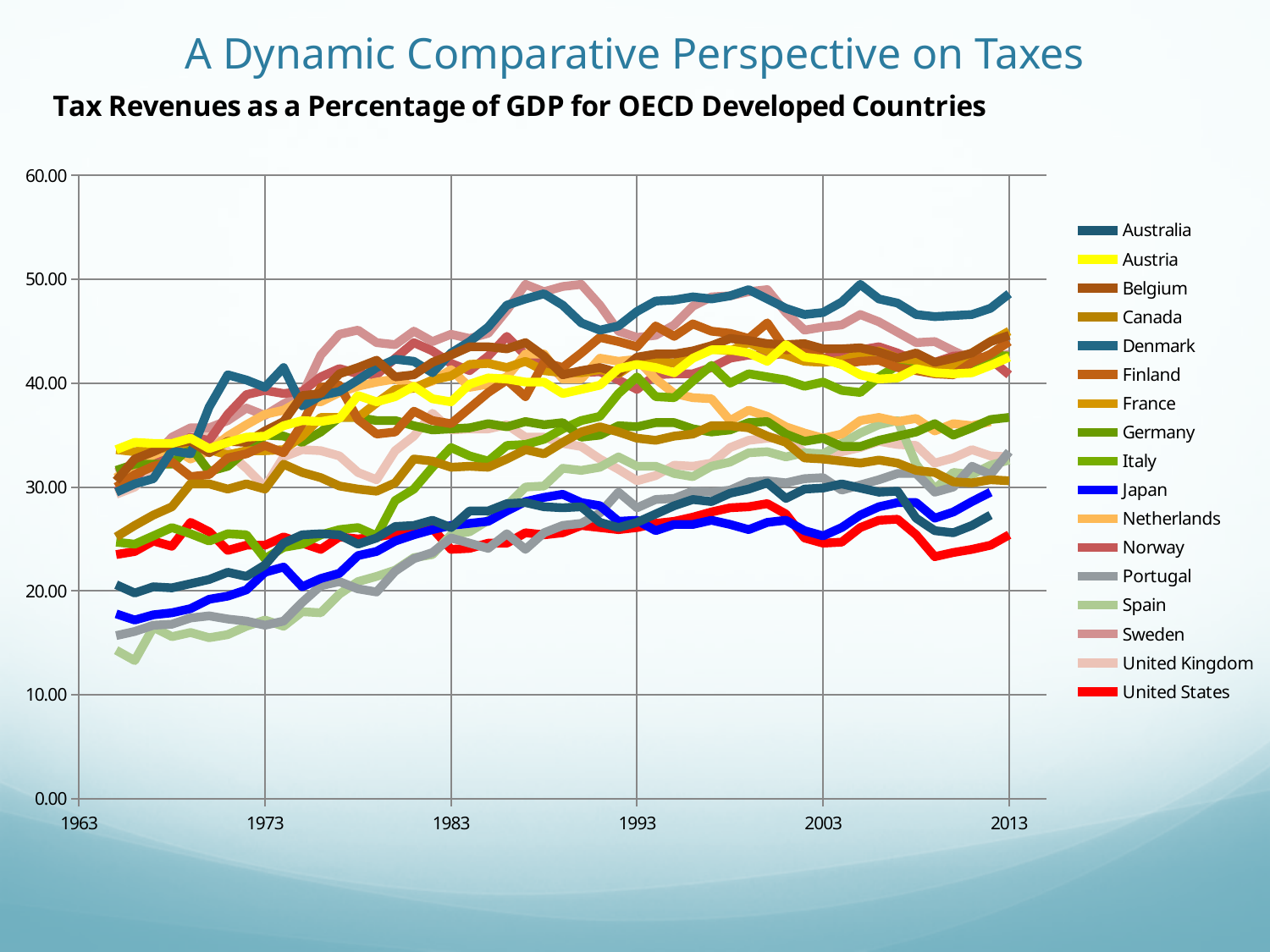
Which country has the lowest tax revenue as a percentage of GDP in 2013? United States How many countries are listed in the chart's legend? 17 What kind of chart is shown on the slide? line chart Is the value for Japan in 1993 greater or less than 40? less What is the title of the chart? Tax Revenues as a Percentage of GDP for OECD Developed Countries Is the value for Denmark in 2013 greater or less than 40? greater Which country has the highest tax revenue as a percentage of GDP in 2013? Denmark Is the value for Spain at the start of the series (mid-1960s) greater or less than 20? less Which colour represents the United States in the chart? red In 2013, which is larger: the value for Denmark or the value for the United States? Denmark Does the value for Spain generally rise or fall from the 1960s to 2013? rise